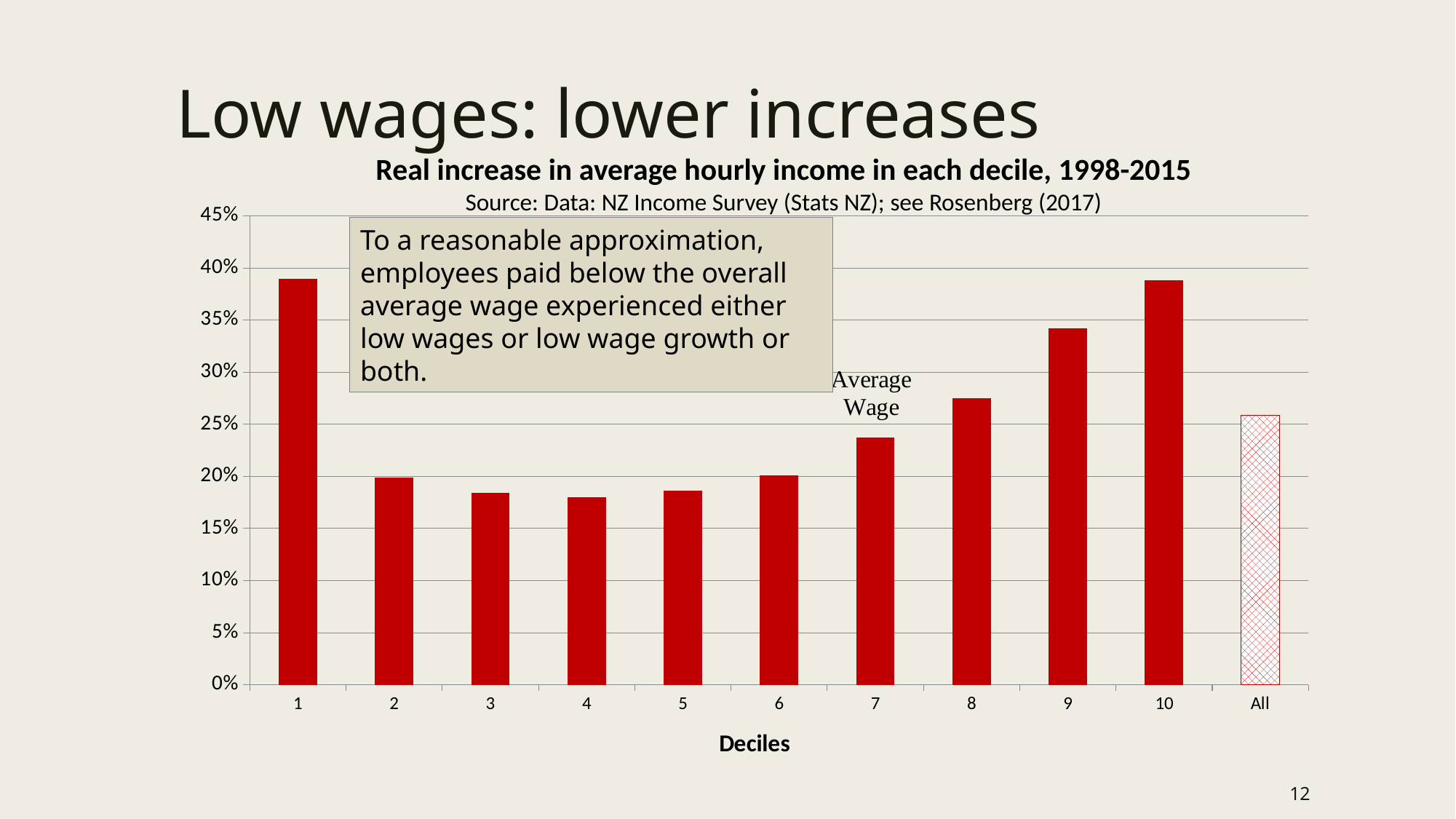
What is the label on the x axis of the chart? Deciles Is the value for decile 9 greater or less than 30%? greater Which has the larger value, decile 3 or decile 8? decile 8 Which has the larger value, decile 9 or decile 2? decile 9 What is the title of the chart? Real increase in average hourly income in each decile, 1998-2015 Is the value for decile 1 greater or less than 35%? greater How many bars are plotted in the chart? 11 Is the value for decile 2 greater or less than 25%? less Do the values rise or fall from decile 4 to decile 10? rise What kind of chart is shown on the slide? bar chart